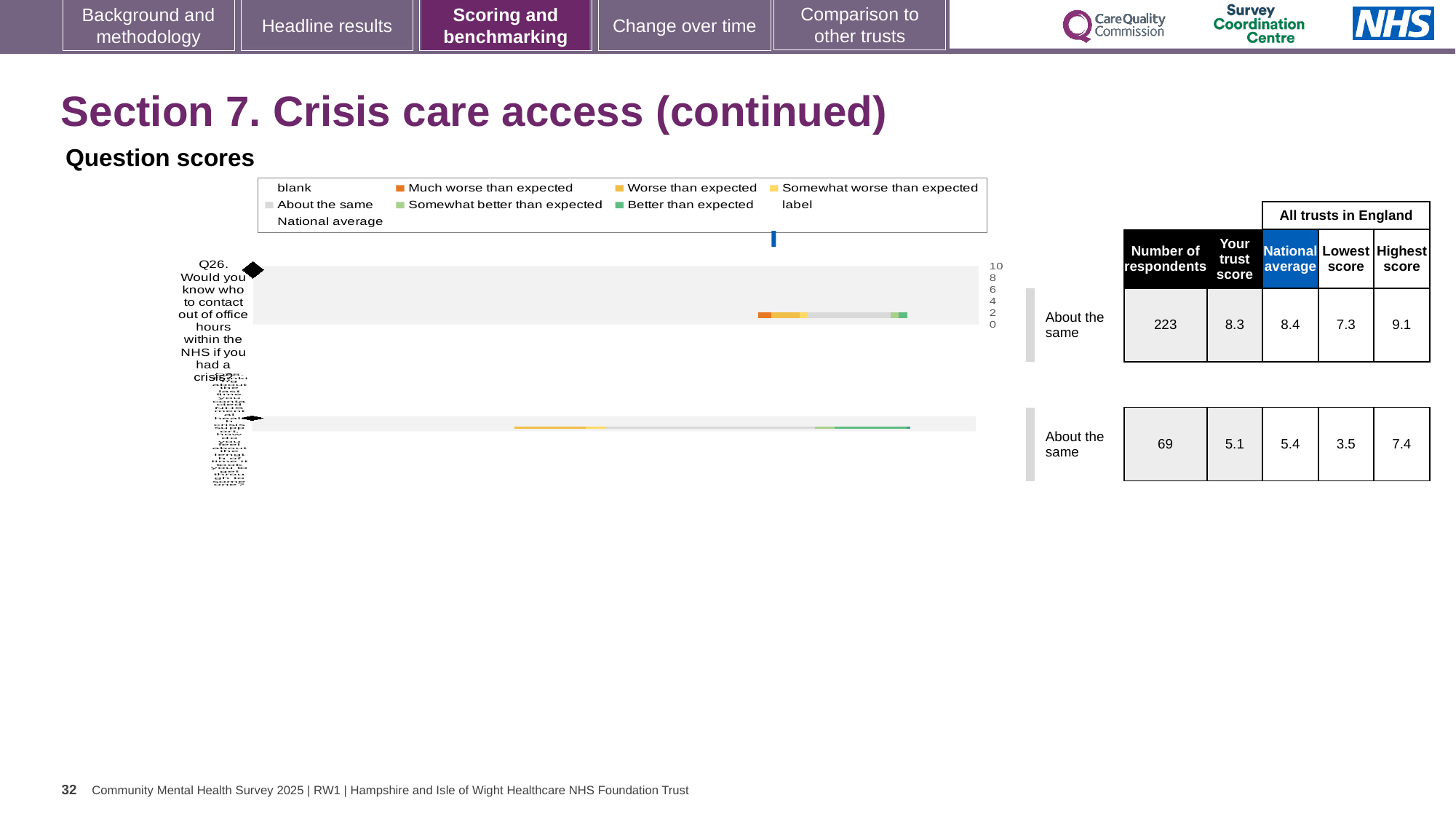
For Q26, what is the lowest score among all trusts in England? 7.3 For Q26, how many respondents are shown? 223 For Q26, how is the trust's result categorised relative to other trusts? About the same What is the highest value shown on the chart's axis? 10 For Q26, what is the highest score among all trusts in England? 9.1 For Q26, is the trust score greater or less than 8? greater For Q26, what is the trust's score? 8.3 For Q26, which is larger: the trust score or the national average? national average What colour does the legend use for 'Much worse than expected'? orange For Q26, what is the difference between the highest and lowest scores among all trusts in England? 1.8 What kind of chart is shown under 'Question scores'? bar chart For Q26, what is the national average score? 8.4